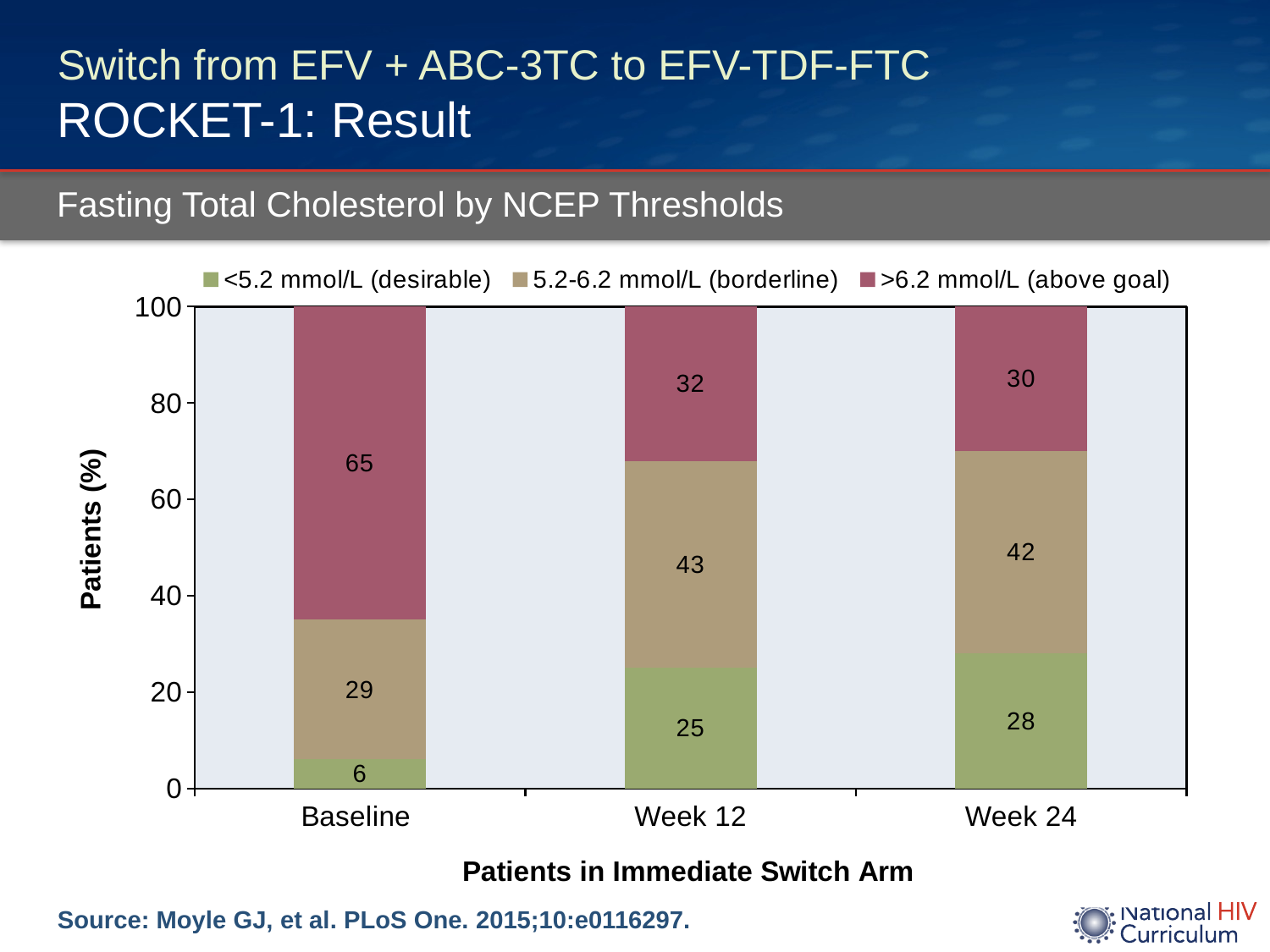
How many series does the legend list? 3 At which time point is the <5.2 mmol/L (desirable) share lowest? Baseline What kind of chart is shown on the slide? Stacked bar chart What percentage of patients were in the 5.2-6.2 mmol/L (borderline) category at Week 12? 43 At which time point is the >6.2 mmol/L (above goal) share highest? Baseline What is the label of the y axis? Patients (%) What is the difference between the >6.2 mmol/L (above goal) percentage at Baseline and at Week 24? 35 Does the >6.2 mmol/L (above goal) percentage rise or fall from Baseline to Week 24? Fall How many time points are shown on the x axis? 3 What percentage of patients had total cholesterol >6.2 mmol/L (above goal) at Baseline? 65 Which is larger: the 5.2-6.2 mmol/L (borderline) value at Week 12 or at Week 24? Week 12 What percentage of patients had total cholesterol <5.2 mmol/L (desirable) at Week 24? 28